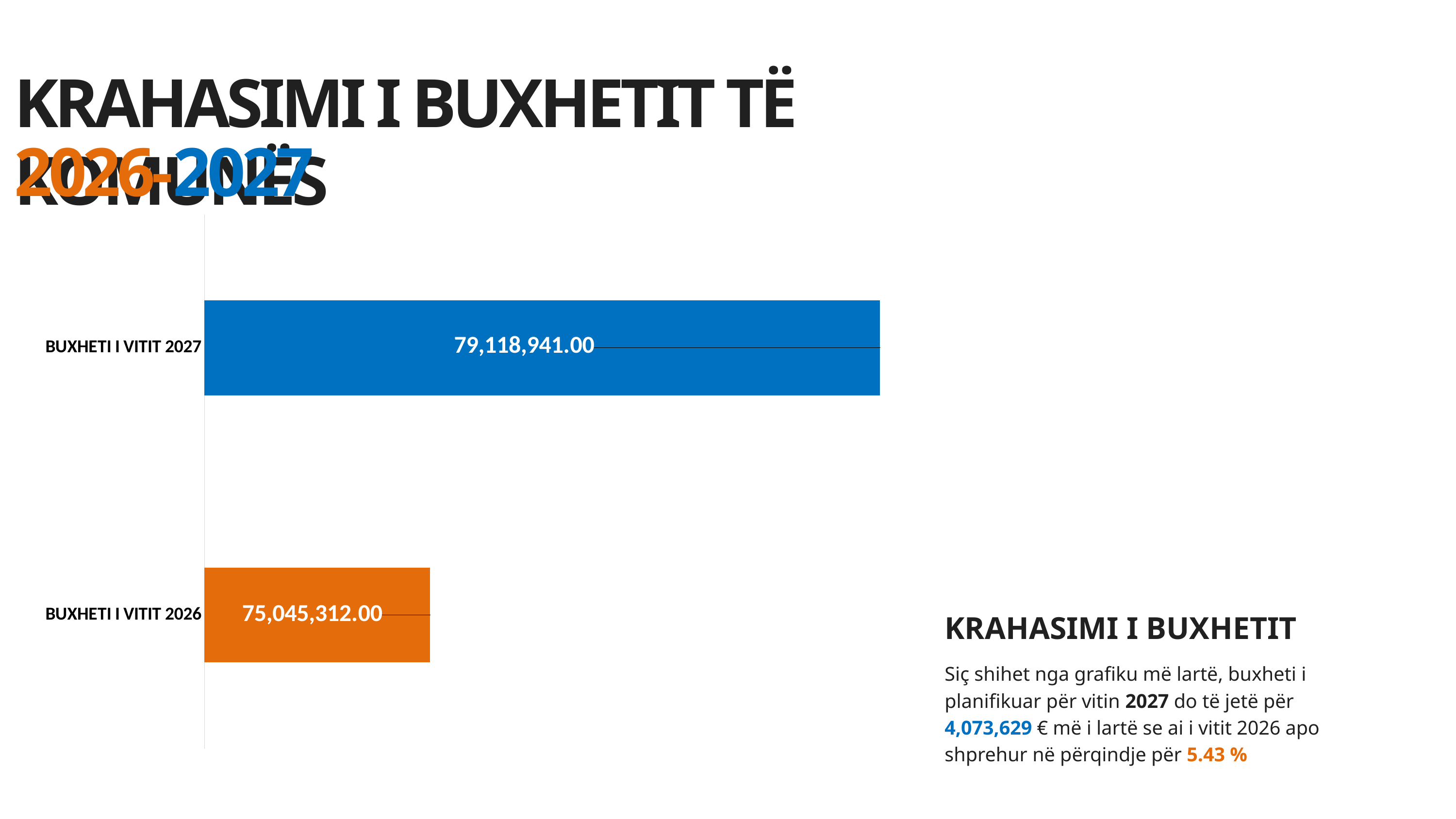
How many categories are plotted in the chart? 2 What colour is the bar for BUXHETI I VITIT 2026? Orange What is the value shown for BUXHETI I VITIT 2026? 75,045,312.00 What kind of chart is shown on the slide? Bar chart What is the value shown for BUXHETI I VITIT 2027? 79,118,941.00 What colour is the bar for BUXHETI I VITIT 2027? Blue What is the difference between the values for BUXHETI I VITIT 2027 and BUXHETI I VITIT 2026? 4,073,629.00 Which is larger, the value for BUXHETI I VITIT 2027 or the value for BUXHETI I VITIT 2026? BUXHETI I VITIT 2027 Which category has the highest value in the chart? BUXHETI I VITIT 2027 Which category has the lowest value in the chart? BUXHETI I VITIT 2026